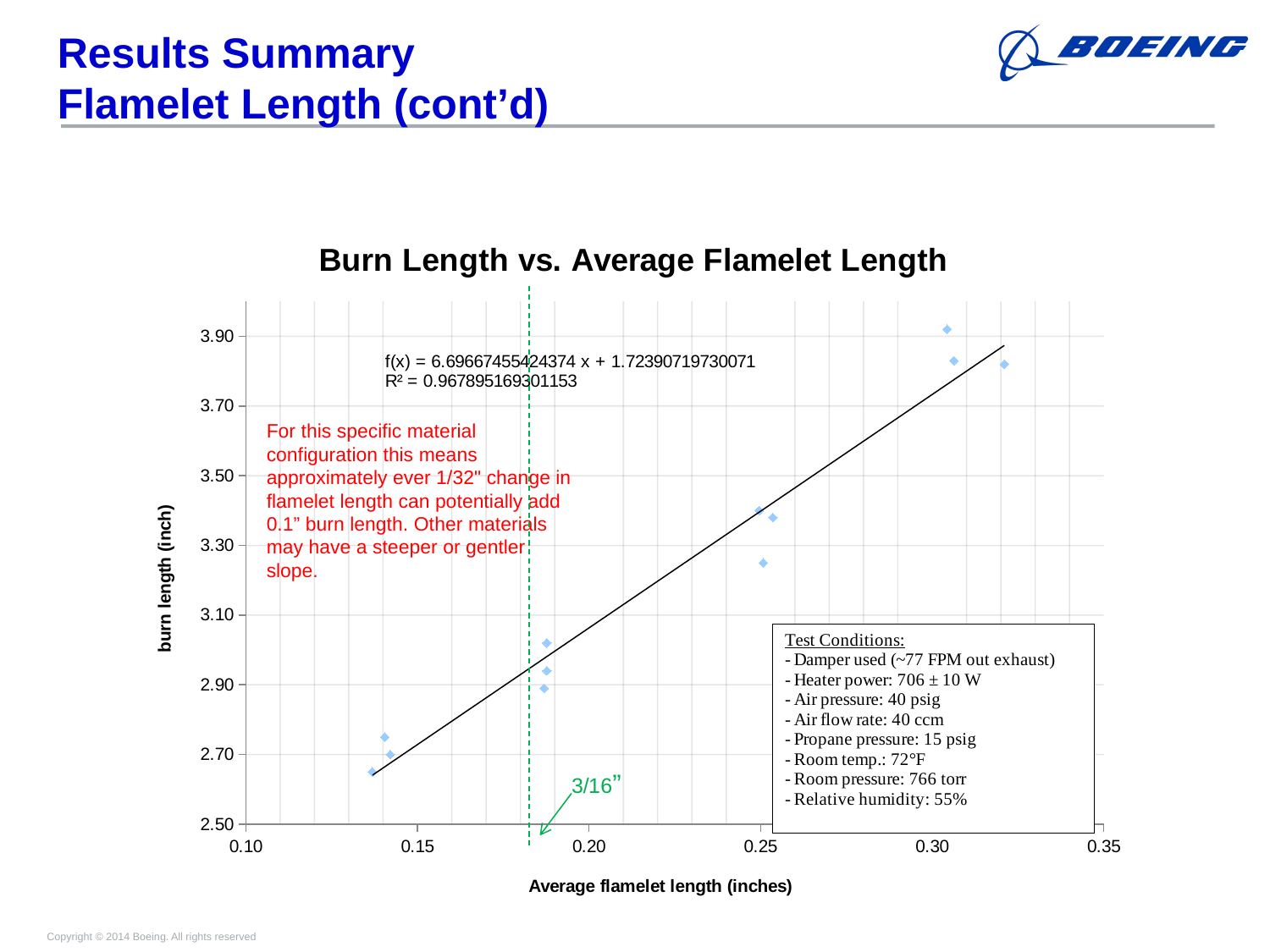
What R² value is printed on the chart for the trendline? 0.967895169301153 Which group of points has the highest burn length: those near 0.14, 0.19, 0.25 or 0.30 inches average flamelet length? Those near 0.30 inches What is the title of the chart? Burn Length vs. Average Flamelet Length How many data points are plotted on the chart? 12 As average flamelet length increases along the x axis, does burn length rise or fall? Rise Are the burn length values for the points near an average flamelet length of 0.14 inches greater or less than 2.90? less What is the label of the y axis? burn length (inch) What kind of chart is shown on the slide? Scatter chart Are the burn length values for the points near an average flamelet length of 0.25 inches greater or less than 3.50? less Are the burn length values for the points near an average flamelet length of 0.30 inches greater or less than 3.70? greater Which has the larger burn length: the points near 0.25 inches or the points near 0.19 inches average flamelet length? The points near 0.25 inches What is the slope of the fitted line f(x) printed on the chart? 6.69667455424374